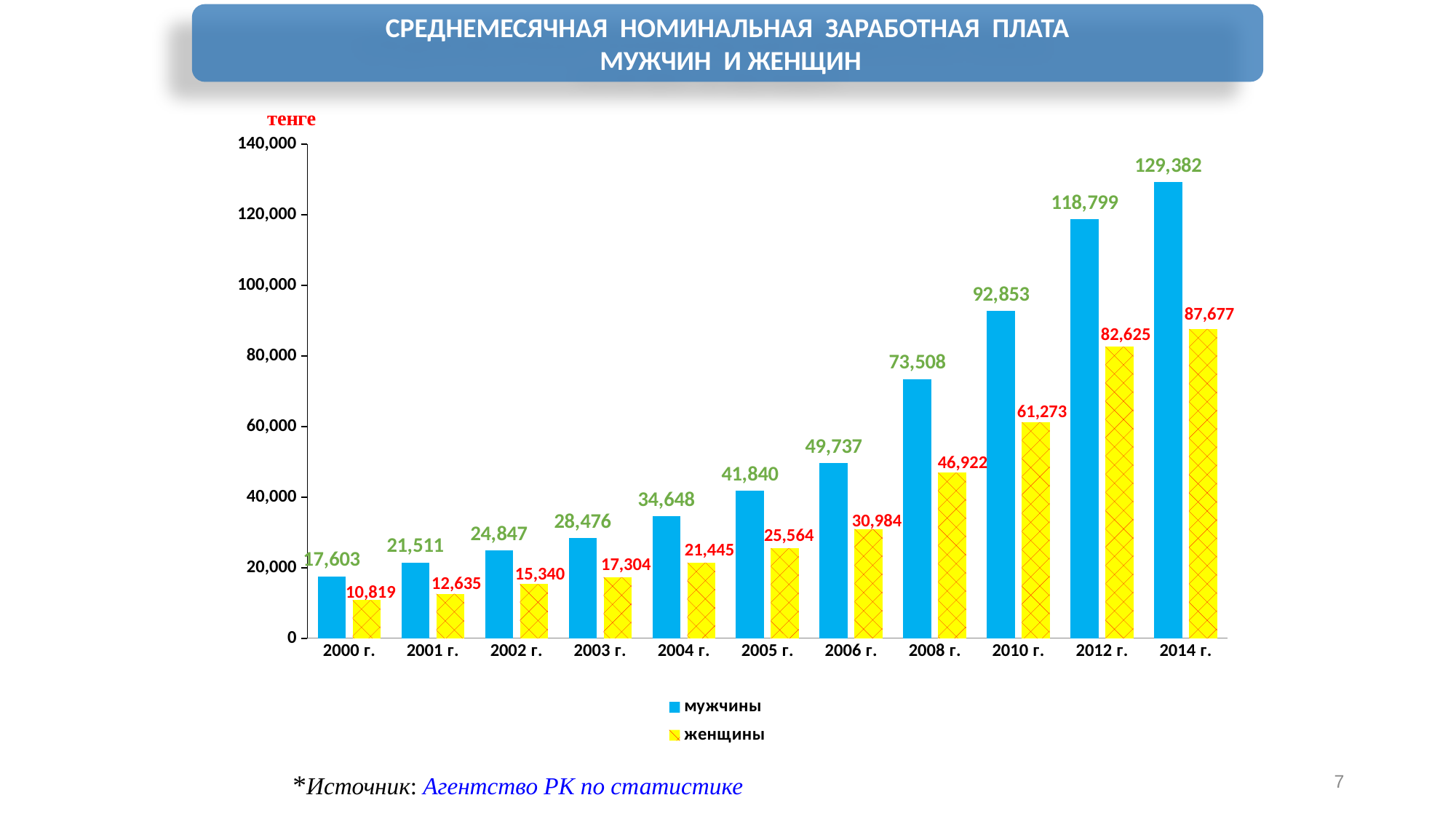
How many series does the legend list? 2 Do the values for мужчины rise or fall from 2000 г. to 2014 г.? rise What is the value for женщины in 2008 г.? 46,922 In which year is the value for мужчины the lowest? 2000 г. What is the difference between the мужчины and женщины values in 2010 г.? 31,580 What is the difference between the мужчины and женщины values in 2014 г.? 41,705 What is the value for мужчины in 2005 г.? 41,840 In which year is the value for женщины the highest? 2014 г. How many years are shown on the x axis? 11 What is the value for мужчины in 2014 г.? 129,382 Which is larger in 2012 г.: the value for мужчины or the value for женщины? мужчины What is the value for женщины in 2000 г.? 10,819